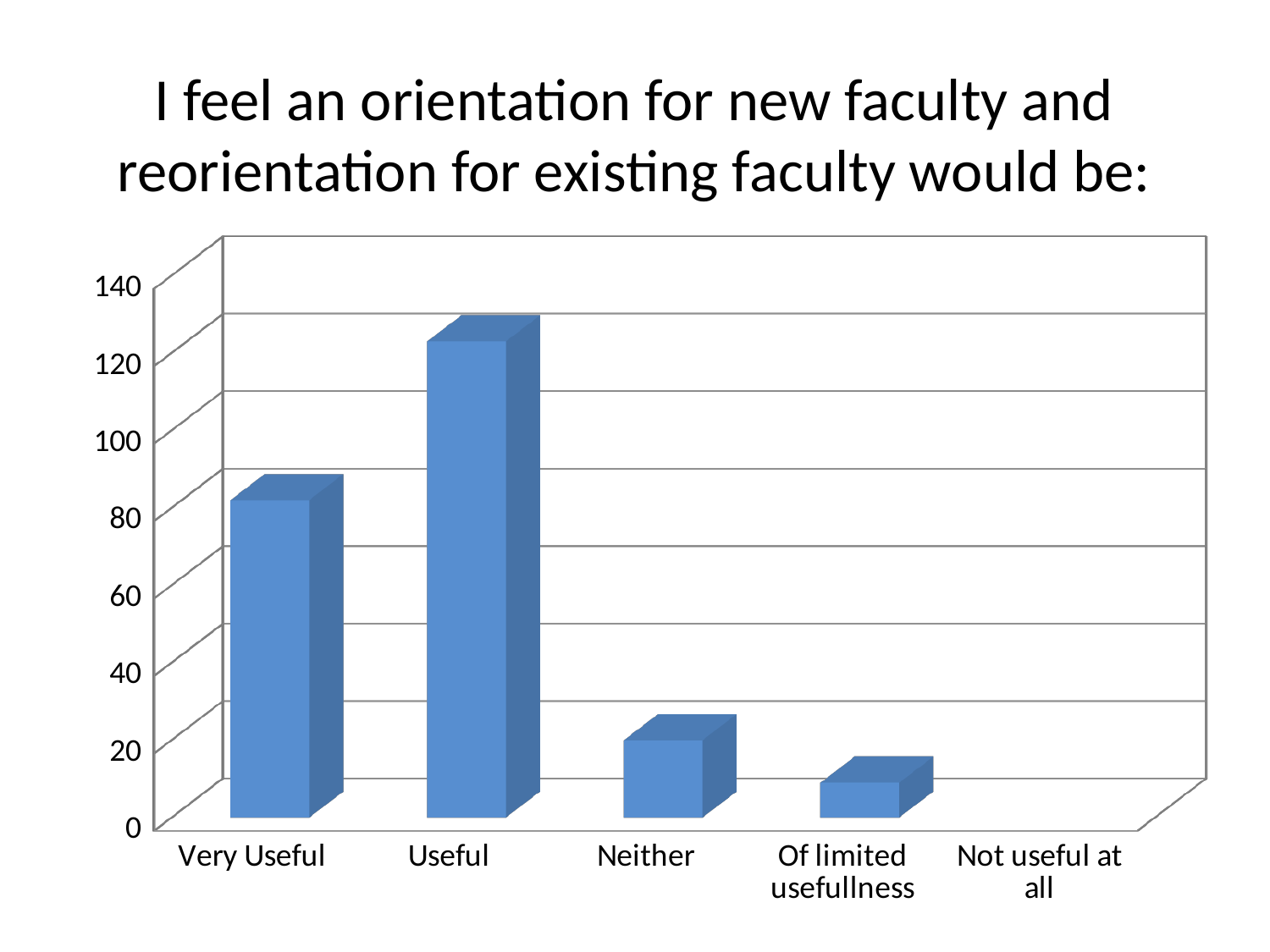
How many categories are shown on the x axis of the chart? 5 Is the value for Of limited usefullness greater or less than 20? less Is the value for Useful greater or less than 100? greater Which is larger, the value for Very Useful or the value for Useful? Useful What kind of chart is shown on the slide? bar chart What is the title of the slide containing the chart? I feel an orientation for new faculty and reorientation for existing faculty would be: Is the value for Very Useful greater or less than 60? greater Which category has the highest value in the chart? Useful Which is larger, the value for Neither or the value for Of limited usefullness? Neither Do the values rise or fall along the x axis from Useful to Not useful at all? fall